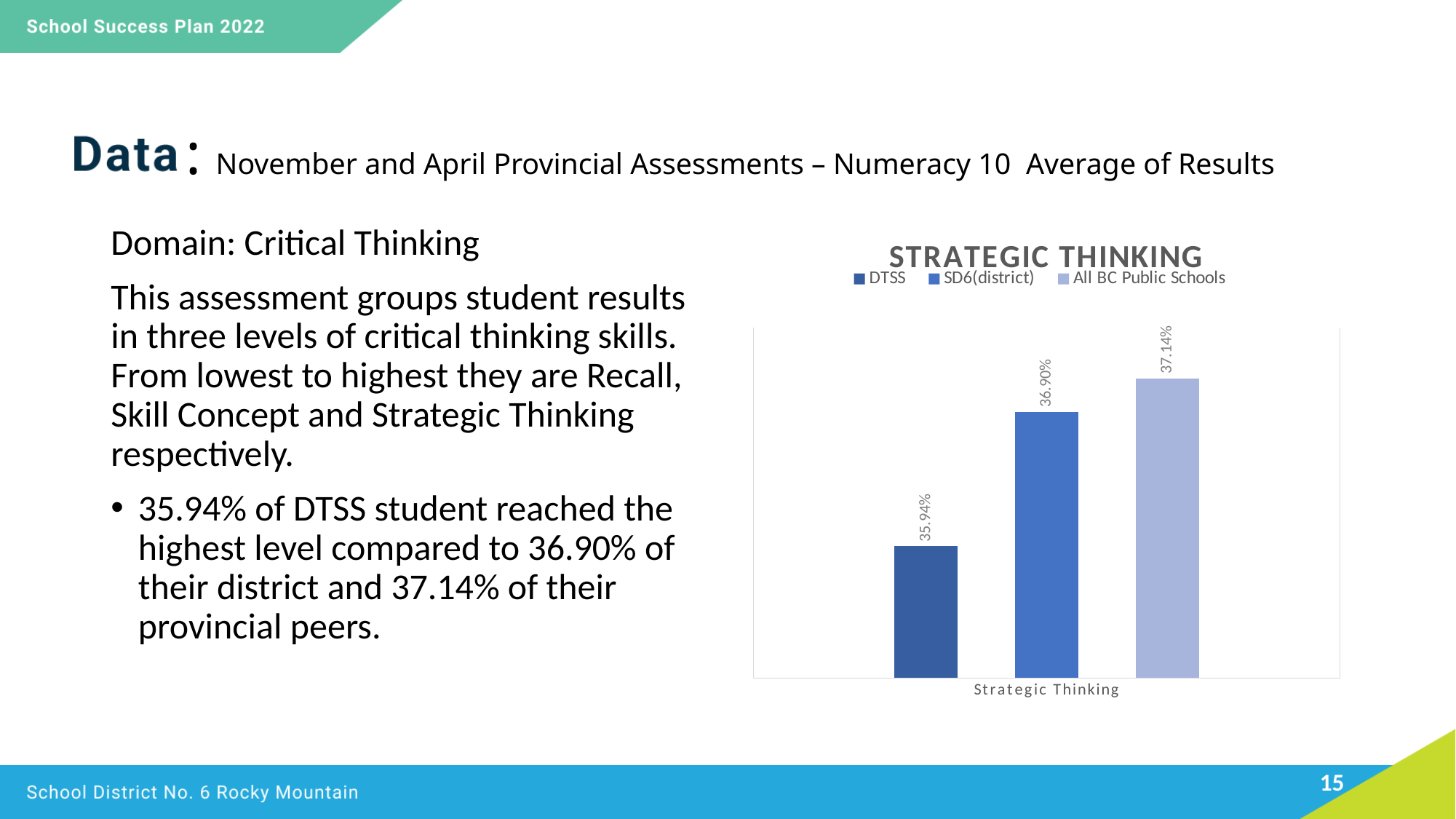
How many bars are plotted in the Strategic Thinking chart? 3 What is the value for DTSS in the Strategic Thinking chart? 35.94% What is the value for All BC Public Schools in the Strategic Thinking chart? 37.14% Which is larger in the Strategic Thinking chart, the value for DTSS or the value for SD6(district)? SD6(district) What is the value for SD6(district) in the Strategic Thinking chart? 36.90% How many series does the legend of the Strategic Thinking chart list? 3 What is the difference between the SD6(district) value and the DTSS value in the Strategic Thinking chart? 0.96% Which series has the highest value in the Strategic Thinking chart? All BC Public Schools What is the difference between the All BC Public Schools value and the DTSS value in the Strategic Thinking chart? 1.20% Which series has the lowest value in the Strategic Thinking chart? DTSS What kind of chart is the Strategic Thinking chart? Bar chart What is the title of the chart on the slide? STRATEGIC THINKING